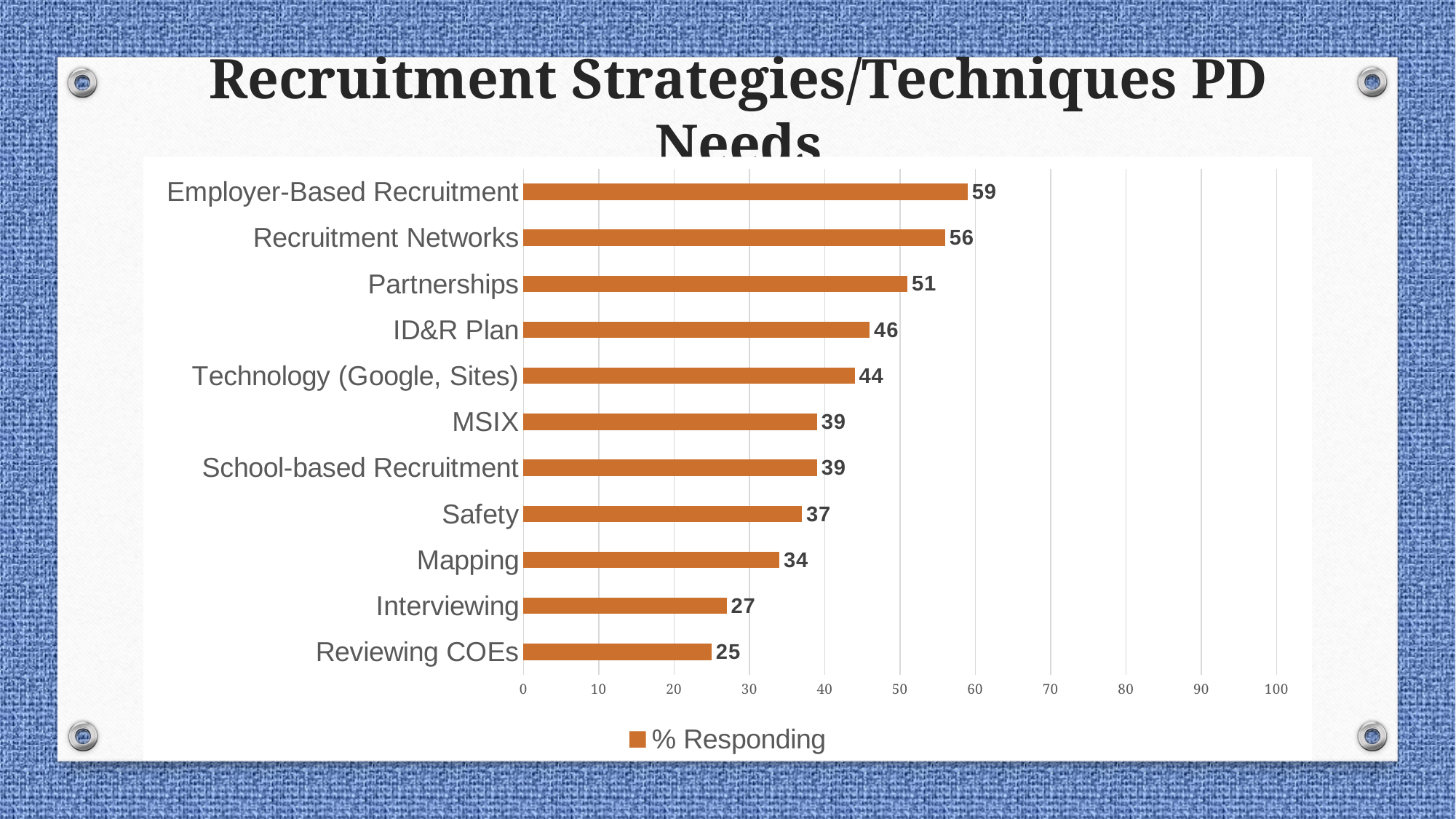
Which is larger, the value for Safety or the value for Mapping? Safety What series name does the legend show? % Responding Is the value for MSIX greater or less than 50? less Which category has the highest value? Employer-Based Recruitment What is the difference between the values for ID&R Plan and Interviewing? 19 What is the value for Technology (Google, Sites)? 44 What kind of chart is shown on the slide? bar chart What is the difference between the values for Recruitment Networks and Partnerships? 5 How many categories are shown in the chart? 11 What is the value for Mapping? 34 Which category has the lowest value? Reviewing COEs What is the value for Employer-Based Recruitment? 59